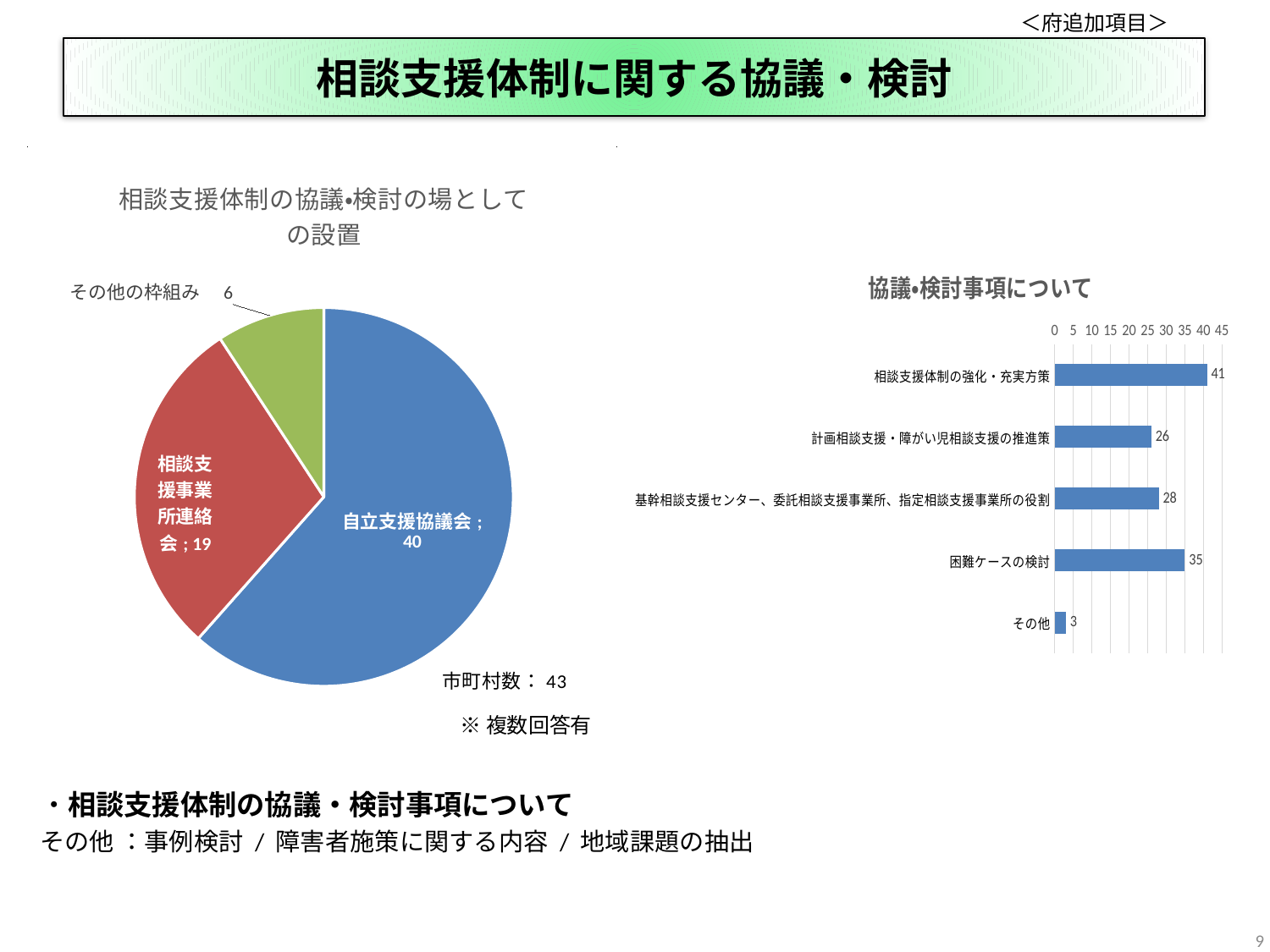
In the bar chart titled 協議•検討事項について, which category has the lowest value? その他 In the pie chart titled 相談支援体制の協議•検討の場としての設置, what is the difference between the values for 自立支援協議会 and 相談支援事業所連絡会? 21 In the bar chart titled 協議•検討事項について, what is the difference between the values for 相談支援体制の強化・充実方策 and 困難ケースの検討? 6 In the pie chart titled 相談支援体制の協議•検討の場としての設置, which category has the smallest slice? その他の枠組み In the bar chart titled 協議•検討事項について, what is the value for 困難ケースの検討? 35 In the bar chart titled 協議•検討事項について, which is larger: the value for 基幹相談支援センター、委託相談支援事業所、指定相談支援事業所の役割 or the value for 計画相談支援・障がい児相談支援の推進策? 基幹相談支援センター、委託相談支援事業所、指定相談支援事業所の役割 In the pie chart titled 相談支援体制の協議•検討の場としての設置, what is the value for 自立支援協議会? 40 In the bar chart titled 協議•検討事項について, which category has the highest value? 相談支援体制の強化・充実方策 What kind of chart is the chart titled 協議•検討事項について? Bar chart In the pie chart titled 相談支援体制の協議•検討の場としての設置, how many slices are there? 3 In the bar chart titled 協議•検討事項について, what is the value for 計画相談支援・障がい児相談支援の推進策? 26 In the pie chart titled 相談支援体制の協議•検討の場としての設置, what is the value for 相談支援事業所連絡会? 19